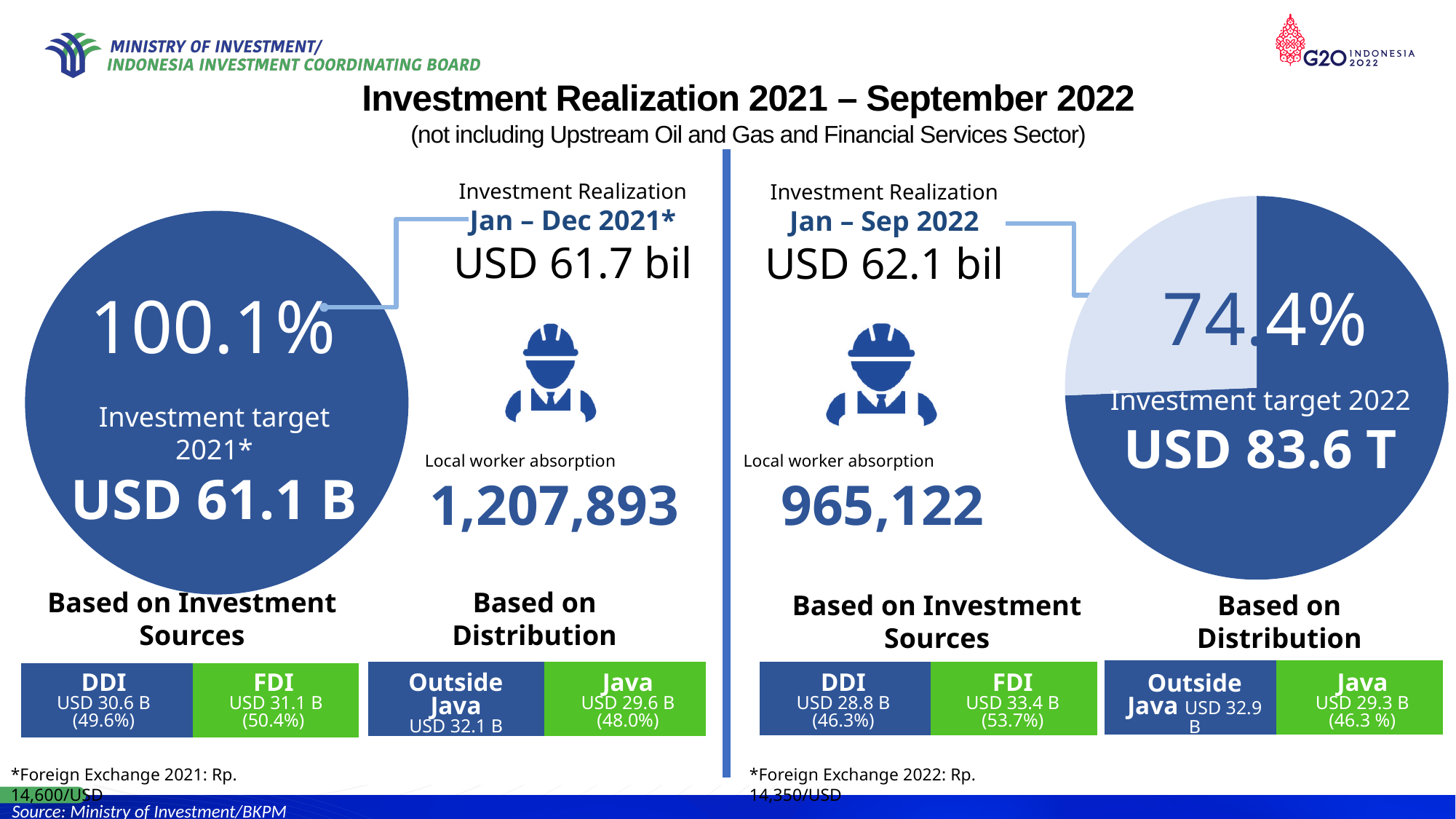
On the right-hand pie chart, what percentage of the 2022 investment target has been realized? 74.4% In the 'Based on Investment Sources' bar for Jan–Sep 2022, what share does FDI hold? 53.7% In the 'Based on Distribution' bar for Jan–Dec 2021, what is the difference between Outside Java (USD 32.1 B) and Java (USD 29.6 B)? USD 2.5 B What kind of chart is used on the right side of the slide to show the 74.4% achievement of the 2022 target? pie chart Is the 2022 target achievement shown on the right-hand pie chart greater or less than 75%? less On the left-hand circle chart, what percentage of the 2021 investment target was achieved? 100.1% On the left-hand circle chart, what is the investment target for 2021? USD 61.1 B In the 'Based on Investment Sources' bar for Jan–Dec 2021, what is the DDI value? USD 30.6 B (49.6%) Which is larger, the target achievement percentage for 2021 (left chart) or for 2022 (right chart)? 2021 (100.1%) In the 'Based on Distribution' bar for Jan–Sep 2022, which is larger, Outside Java or Java? Outside Java On the right-hand pie chart, what is the investment target for 2022? USD 83.6 T What is the difference in percentage points between the 2021 target achievement (100.1%) and the 2022 target achievement (74.4%)? 25.7 percentage points